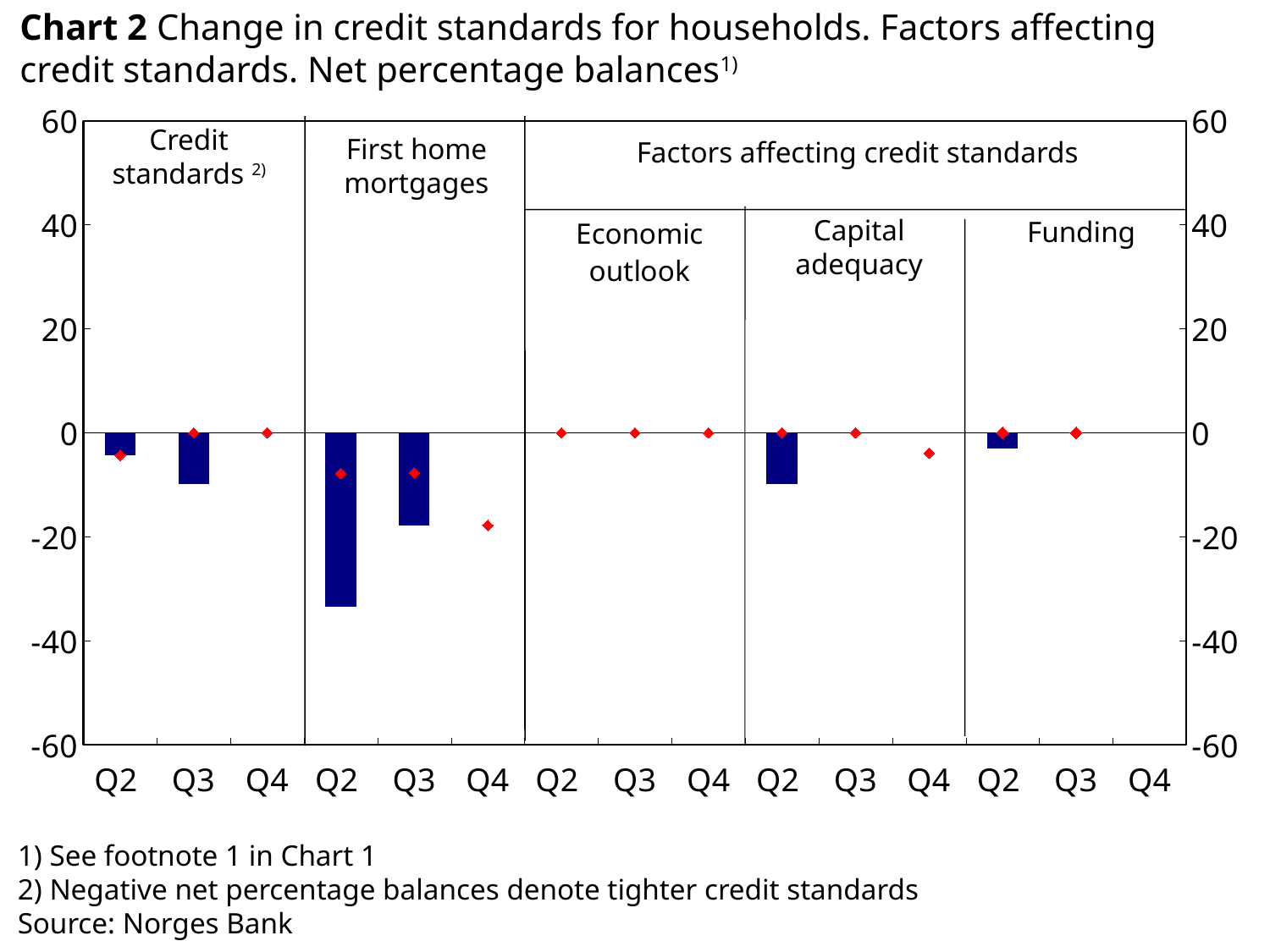
How many panels (groups) are shown along the x axis? 5 Is the Q3 bar for Credit standards greater or less than -20? greater Is the Q2 bar for Capital adequacy greater or less than -20? greater How many quarters are shown in each panel? 3 Within First home mortgages, which quarter has the larger (less negative) bar, Q2 or Q3? Q3 Do the bars for First home mortgages rise or fall from Q2 to Q3? rise What is the source given for the chart? Norges Bank What kind of chart is shown on the slide? combination bar and line chart (bars with red diamond markers) Is the Q3 bar for First home mortgages greater or less than -10? less Which panel contains the lowest (most negative) bar on the chart? First home mortgages Within Credit standards, which quarter has the larger (less negative) bar, Q2 or Q3? Q2